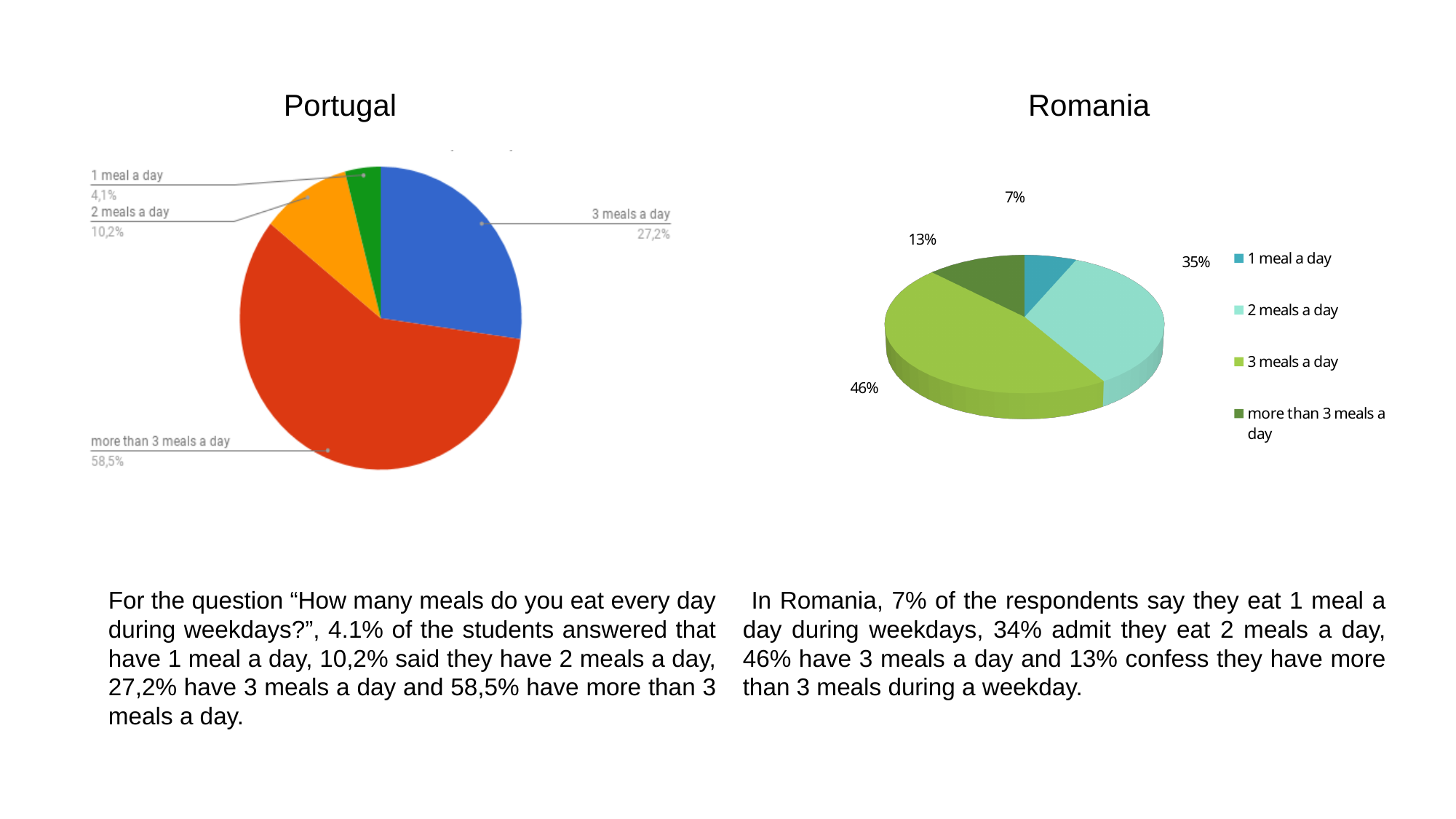
In the Portugal chart, what percentage of students have 1 meal a day? 4,1% In the Portugal chart, what is the value for 2 meals a day? 10,2% In the Portugal chart, what is the difference between the shares for 3 meals a day and 2 meals a day? 17 percentage points In the Portugal chart, which category has the smallest slice? 1 meal a day In the Portugal chart, what share of students have more than 3 meals a day? 58,5% In the Romania chart, which category has the smallest share? 1 meal a day In the Romania chart, what percentage of respondents eat 3 meals a day? 46% In the Romania chart, what is the value for 2 meals a day? 35% In the Romania chart, which is larger: the share for 2 meals a day or the share for more than 3 meals a day? 2 meals a day In the Portugal chart, which category has the largest slice? more than 3 meals a day What type of chart is used for Portugal? Pie chart How many categories does the Romania chart's legend list? 4